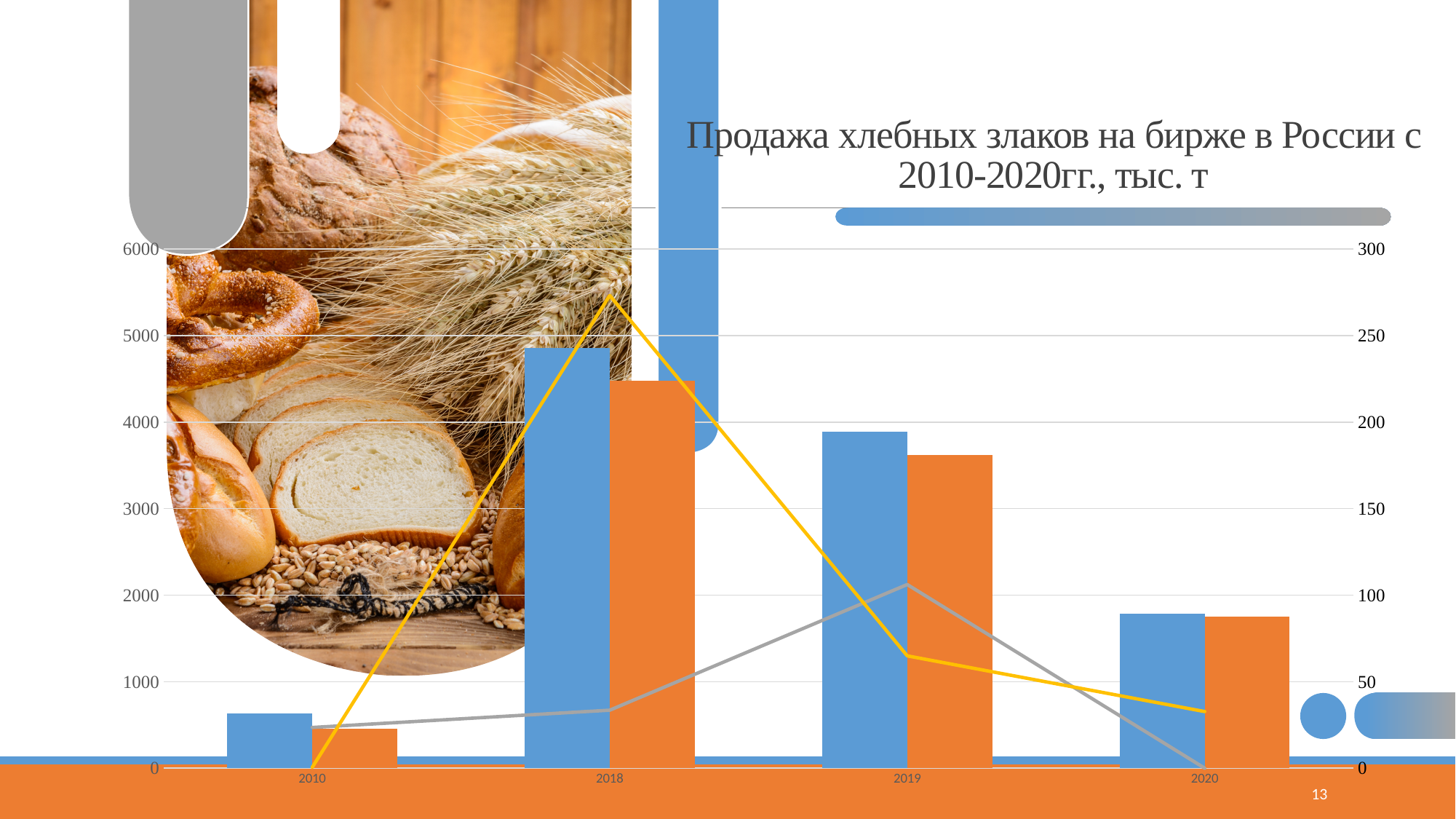
What is the title of the chart? Продажа хлебных злаков на бирже в России с 2010-2020гг., тыс. т In which year is the orange bar highest? 2018 What kind of chart is shown on the slide? Combined bar and line chart Which is larger, the blue bar for 2019 or the blue bar for 2020? The blue bar for 2019 Do the blue bars rise or fall from 2018 to 2020? Fall In which year is the blue bar highest? 2018 How many years are shown on the x axis of the chart? 4 Is the blue bar for 2010 greater or less than 1000 on the left axis? less Is the yellow line's value for 2018 greater or less than 250 on the right axis? greater Is the orange bar for 2020 greater or less than 2000 on the left axis? less In which year is the blue bar lowest? 2010